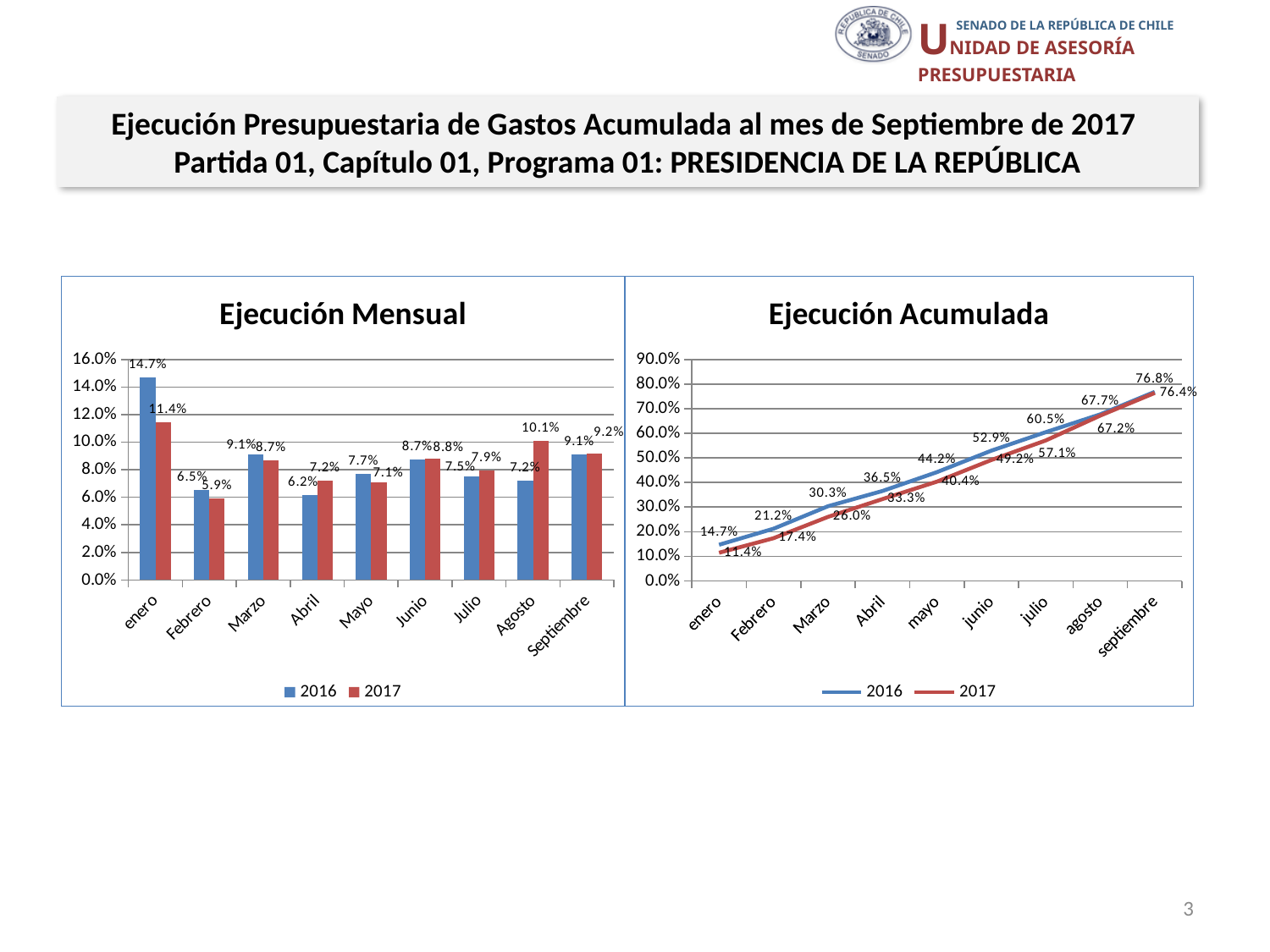
In the 'Ejecución Mensual' chart, which month has the lowest value for 2017? Febrero How many series does the legend of the 'Ejecución Acumulada' chart list? 2 In the 'Ejecución Mensual' chart, what is the difference between the 2016 and 2017 values in enero? 3.3% What kind of chart is 'Ejecución Mensual'? Bar chart In the 'Ejecución Acumulada' chart, what is the value for 2017 in septiembre? 76.4% In the 'Ejecución Mensual' chart, what is the value for 2017 in Agosto? 10.1% In the 'Ejecución Mensual' chart, which is larger in Agosto, the 2016 value or the 2017 value? 2017 In the 'Ejecución Acumulada' chart, do the values rise or fall from enero to septiembre? Rise In the 'Ejecución Mensual' chart, which month has the highest value for 2016? enero In the 'Ejecución Mensual' chart, what is the value for 2016 in enero? 14.7% How many months are shown on the x axis of the 'Ejecución Mensual' chart? 9 In the 'Ejecución Acumulada' chart, what is the value for 2016 in junio? 52.9%